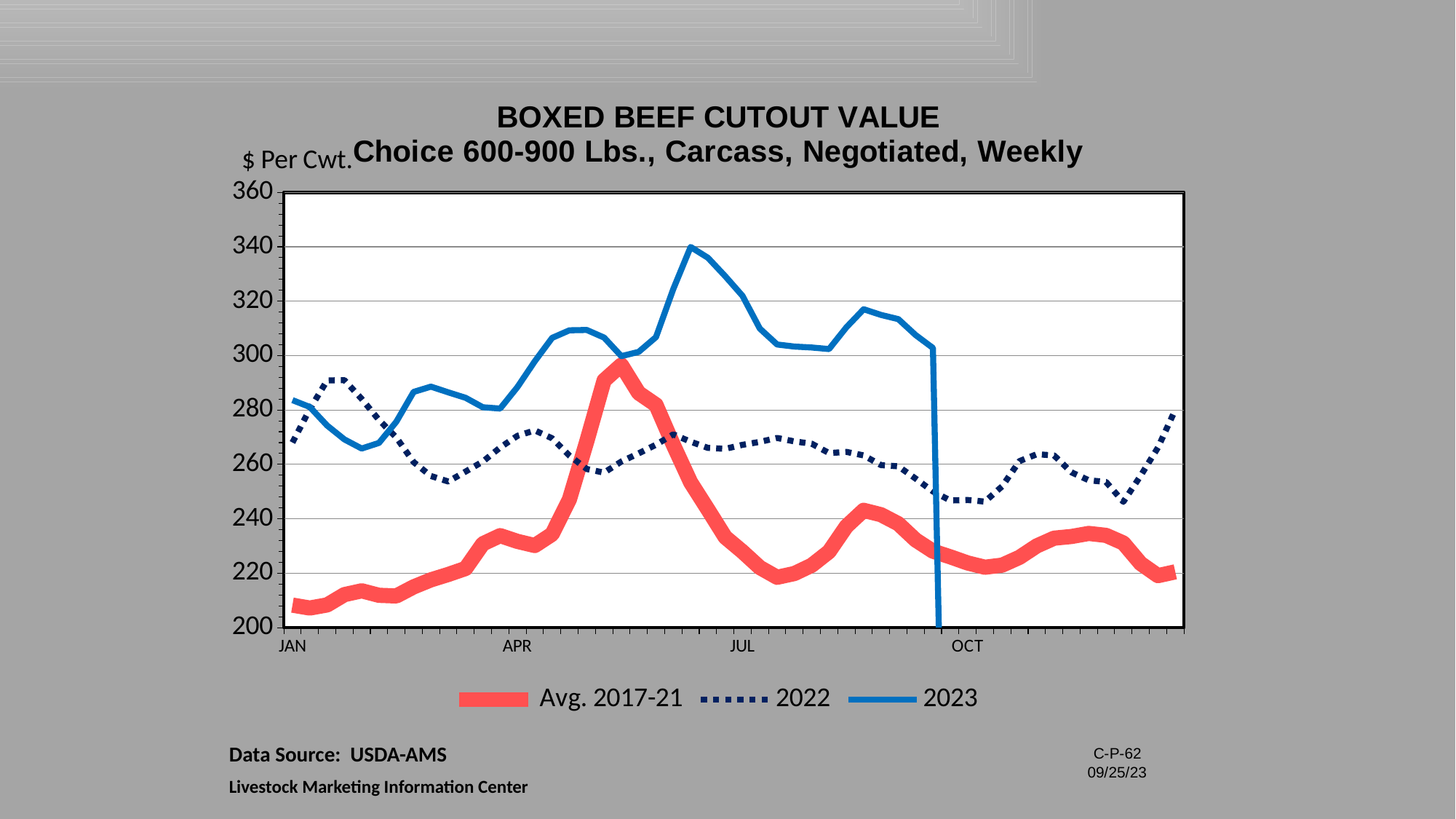
What is the data source named on the slide? USDA-AMS Which series has the lowest value at JAN? Avg. 2017-21 Is the value for 2022 at JAN greater or less than 260? greater At JUL, which series has the larger value, 2022 or 2023? 2023 Which series reaches the highest value on the chart? 2023 How many series does the legend list? 3 Is the peak value of the 2023 series greater or less than 320? greater Does the Avg. 2017-21 series rise or fall from JAN to APR? rise Is the value for Avg. 2017-21 at JAN greater or less than 220? less What is the unit label shown on the y axis? $ Per Cwt. What kind of chart is shown on the slide? line chart